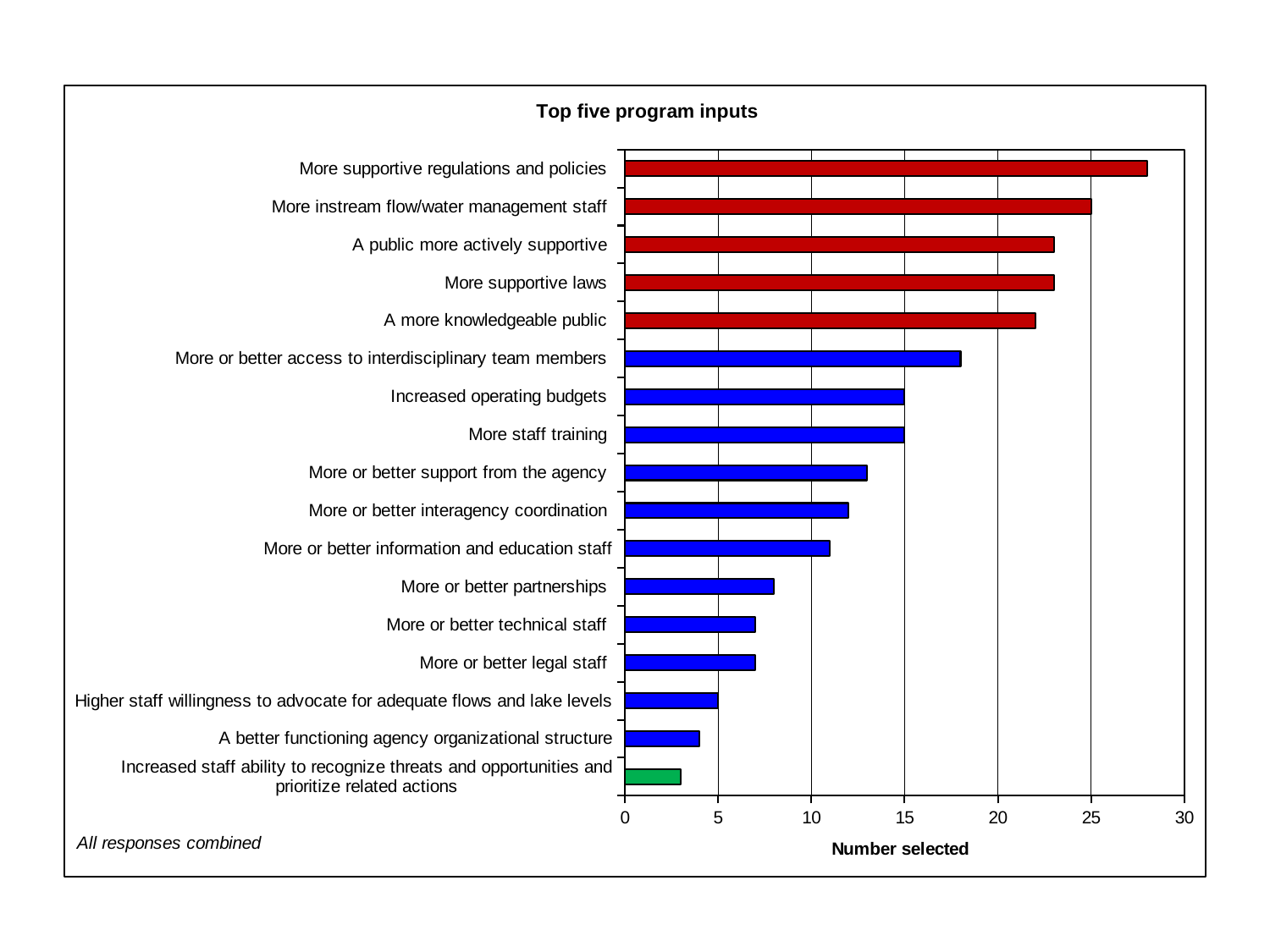
Is the value for More supportive regulations and policies greater or less than 25? greater Which category has the lowest number selected? Increased staff ability to recognize threats and opportunities and prioritize related actions What is the number selected for Higher staff willingness to advocate for adequate flows and lake levels? 5 What kind of chart is shown on the slide? bar chart What is the number selected for More instream flow/water management staff? 25 What is the number selected for Increased operating budgets? 15 Which category has the highest number selected? More supportive regulations and policies How many categories are plotted in the chart? 17 What is the label of the horizontal axis? Number selected Is the value for More or better partnerships greater or less than 10? less Which is larger, the value for More supportive regulations and policies or the value for A more knowledgeable public? More supportive regulations and policies What is the title of the chart? Top five program inputs